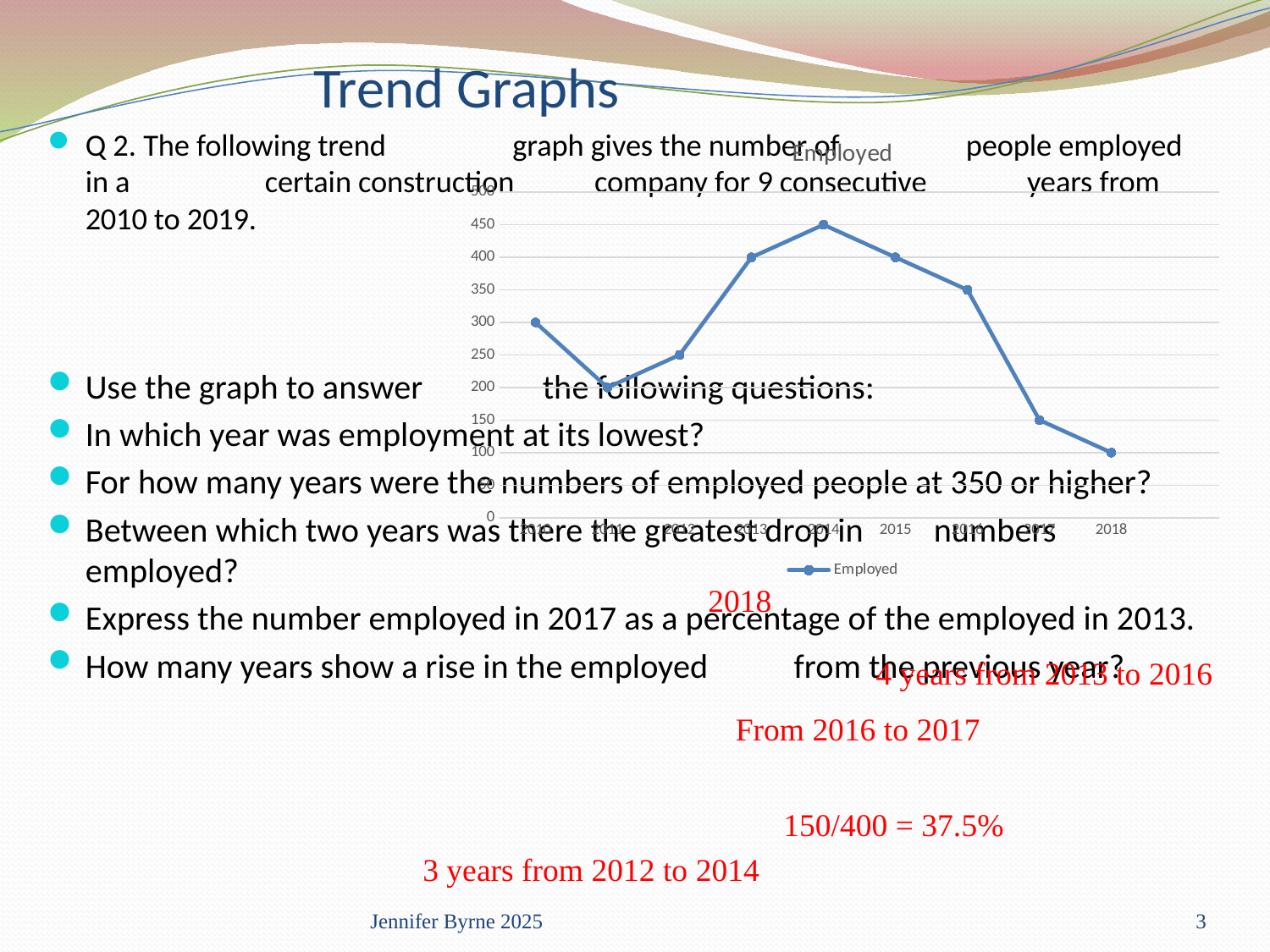
Is the number employed in 2016 greater or less than 300? greater What is the number employed in 2013? 400 In which year is the number employed highest? 2014 How many series does the chart legend list? 1 What is the number employed in 2017? 150 What is the title of the chart? Employed What is the number employed in 2014? 450 Do the values rise or fall from 2014 to 2018? fall How many years are plotted on the x axis of the chart? 9 In which year is the number employed lowest? 2018 Which year has a larger number employed, 2011 or 2012? 2012 What kind of chart is shown on the slide? line chart